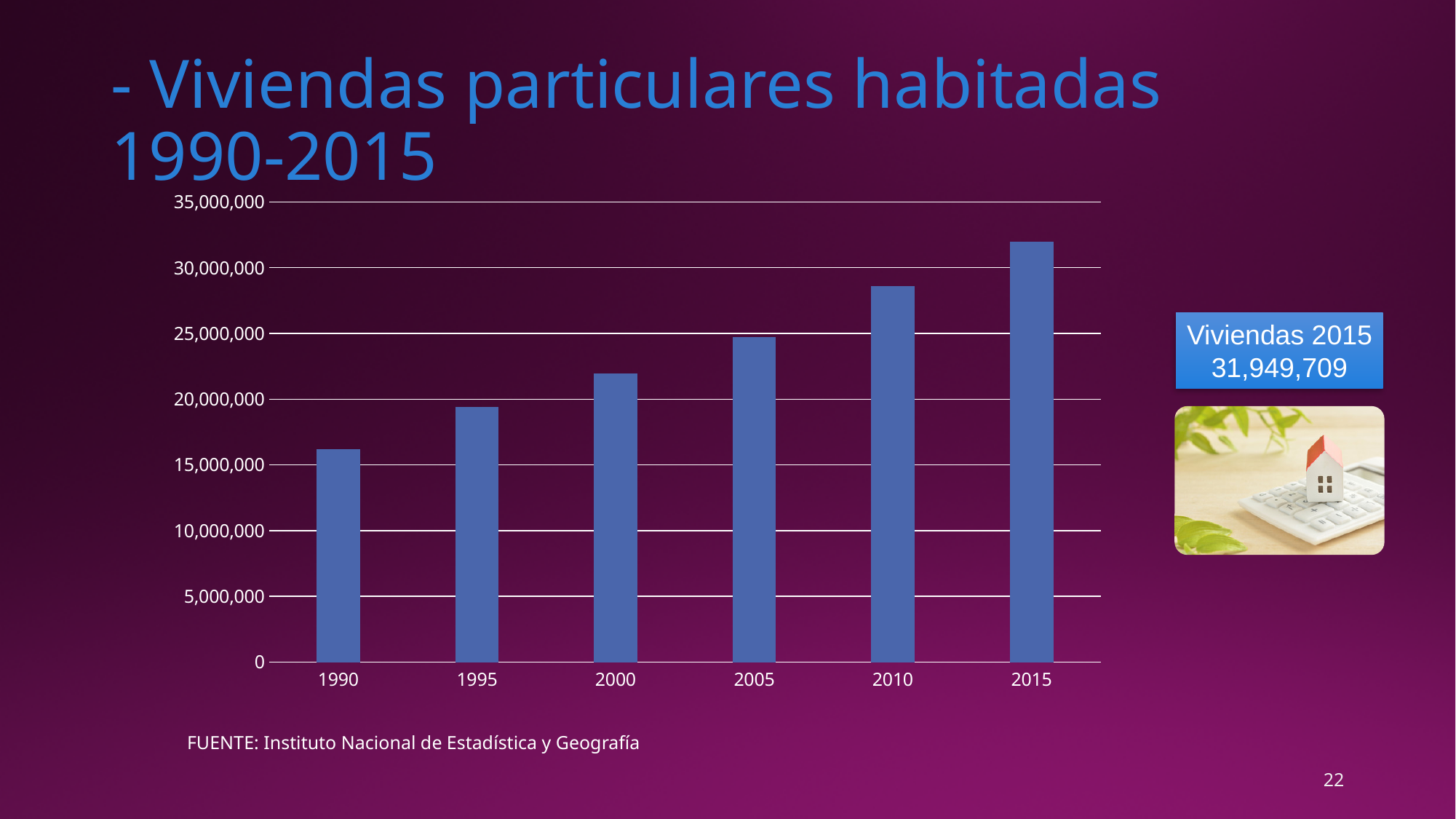
Do the values rise or fall from 1990 to 2015? rise How many years are plotted on the x axis of the chart? 6 Is the value for 2000 greater or less than 20,000,000? greater What is the source cited below the chart? Instituto Nacional de Estadística y Geografía What type of chart is shown on the slide? bar chart Is the value for 1990 greater or less than 15,000,000? greater Is the value for 2010 greater or less than 30,000,000? less What is the number of viviendas for 2015 as shown on the slide? 31,949,709 Which year has the highest number of viviendas particulares habitadas? 2015 Which is larger, the value for 2005 or the value for 2010? 2010 Which year has the lowest number of viviendas particulares habitadas? 1990